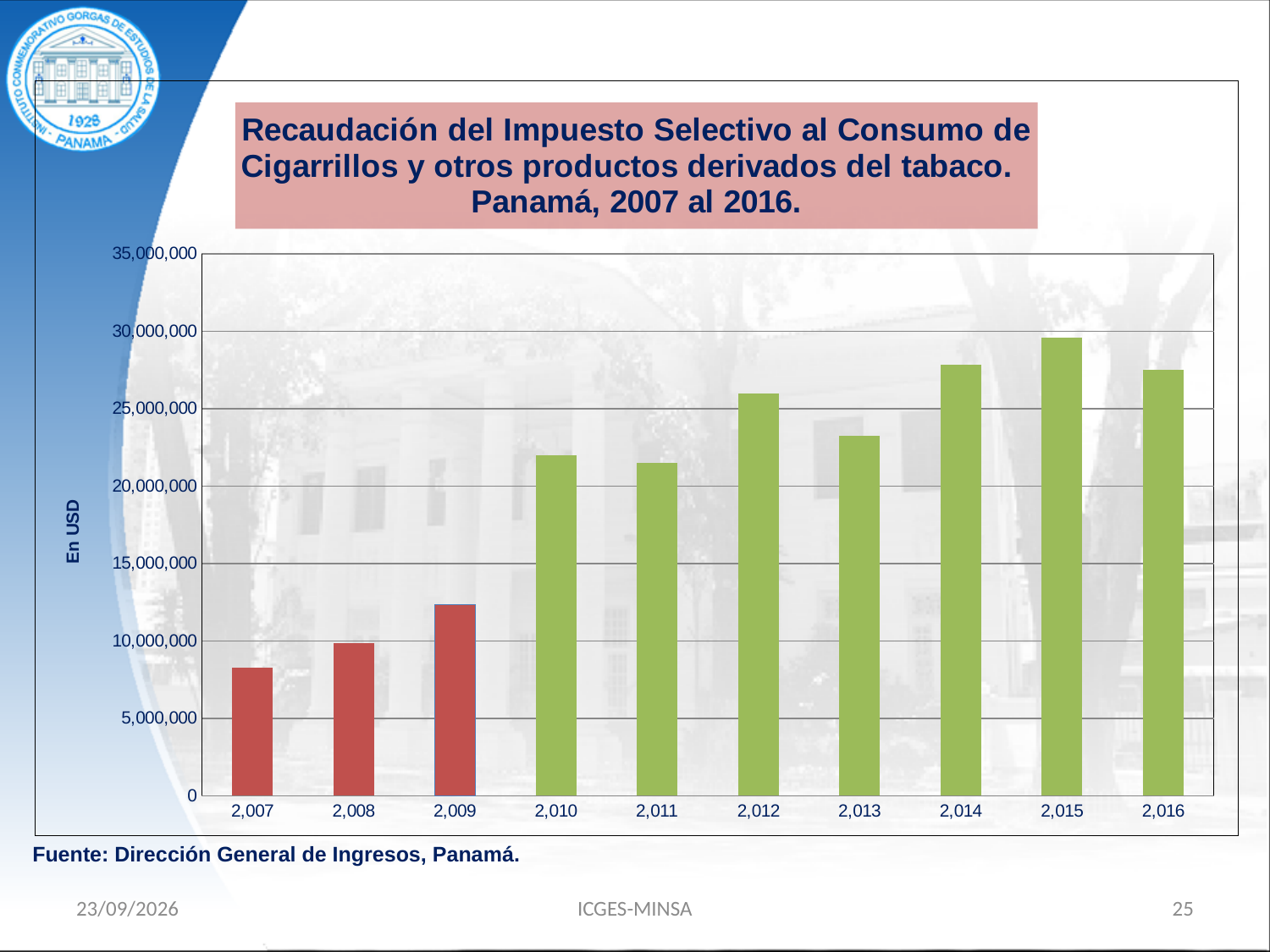
Which year has the lowest tax collection? 2,007 Do the values generally rise or fall from 2,007 to 2,016? Rise Which is larger, the value for 2,014 or the value for 2,013? 2,014 Which year has the highest tax collection? 2,015 What is the label on the vertical axis? En USD Is the value for 2,007 greater or less than 10,000,000? less Which is larger, the value for 2,010 or the value for 2,007? 2,010 Is the value for 2,009 greater or less than 10,000,000? greater Is the value for 2,013 greater or less than 25,000,000? less How many years are plotted on the x axis? 10 What kind of chart is shown on the slide? Bar chart